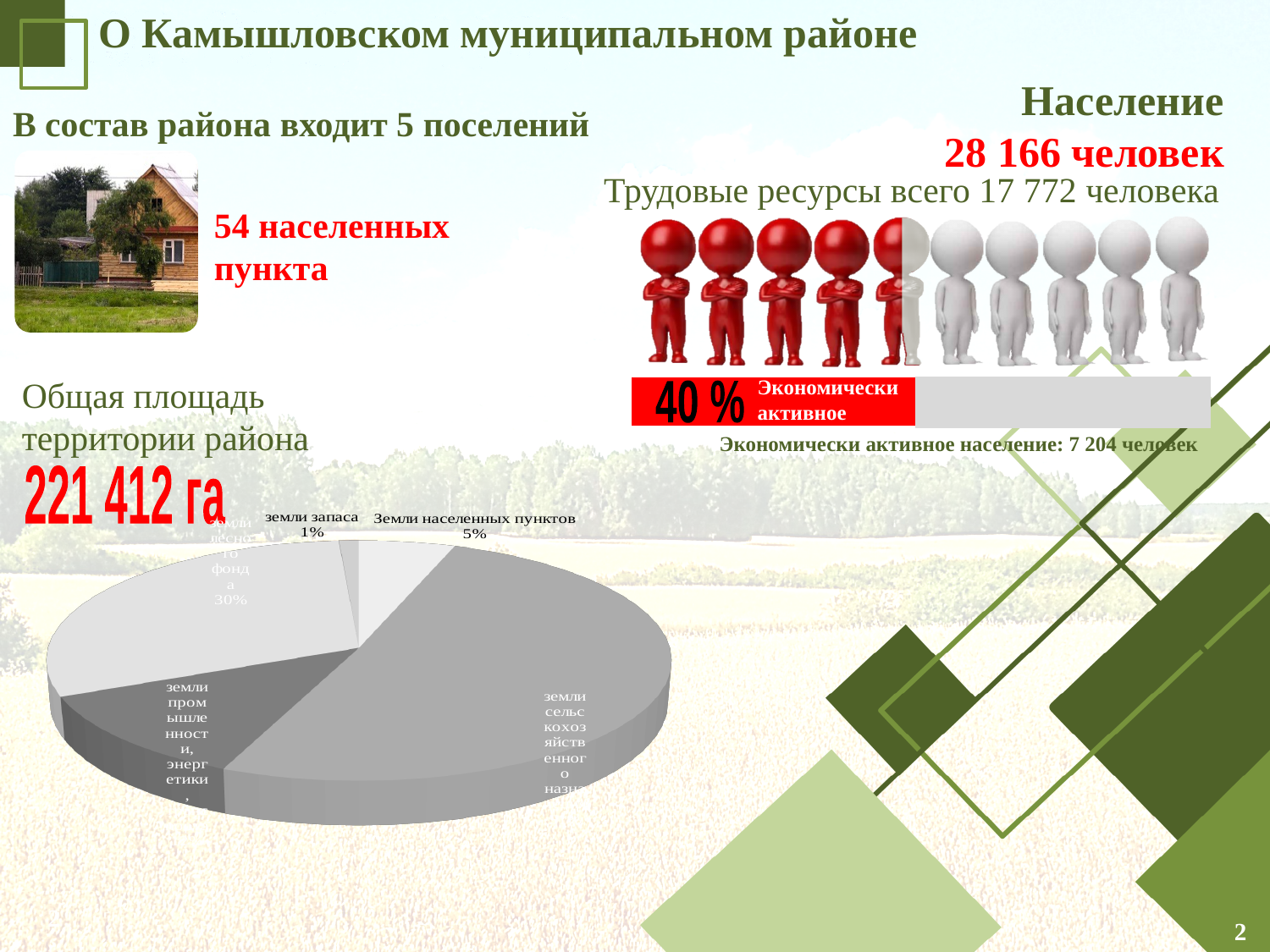
In the land-area pie chart, which is larger: "Земли населенных пунктов" or "земли запаса"? Земли населенных пунктов Is the land-area pie chart drawn in 3D or flat 2D? 3D In the land-area pie chart, by how many percentage points does "Земли населенных пунктов" exceed "земли запаса"? 4 percentage points In the land-area pie chart, what share is labelled for "Земли населенных пунктов"? 5% What total land area figure is shown next to the pie chart? 221 412 га What kind of chart is used to show the distribution of the district's land area? pie chart In the land-area pie chart, which slice is the largest? земли сельскохозяйственного назначения In the land-area pie chart, what share is labelled for "земли запаса"? 1% How many slices does the land-area pie chart have? 5